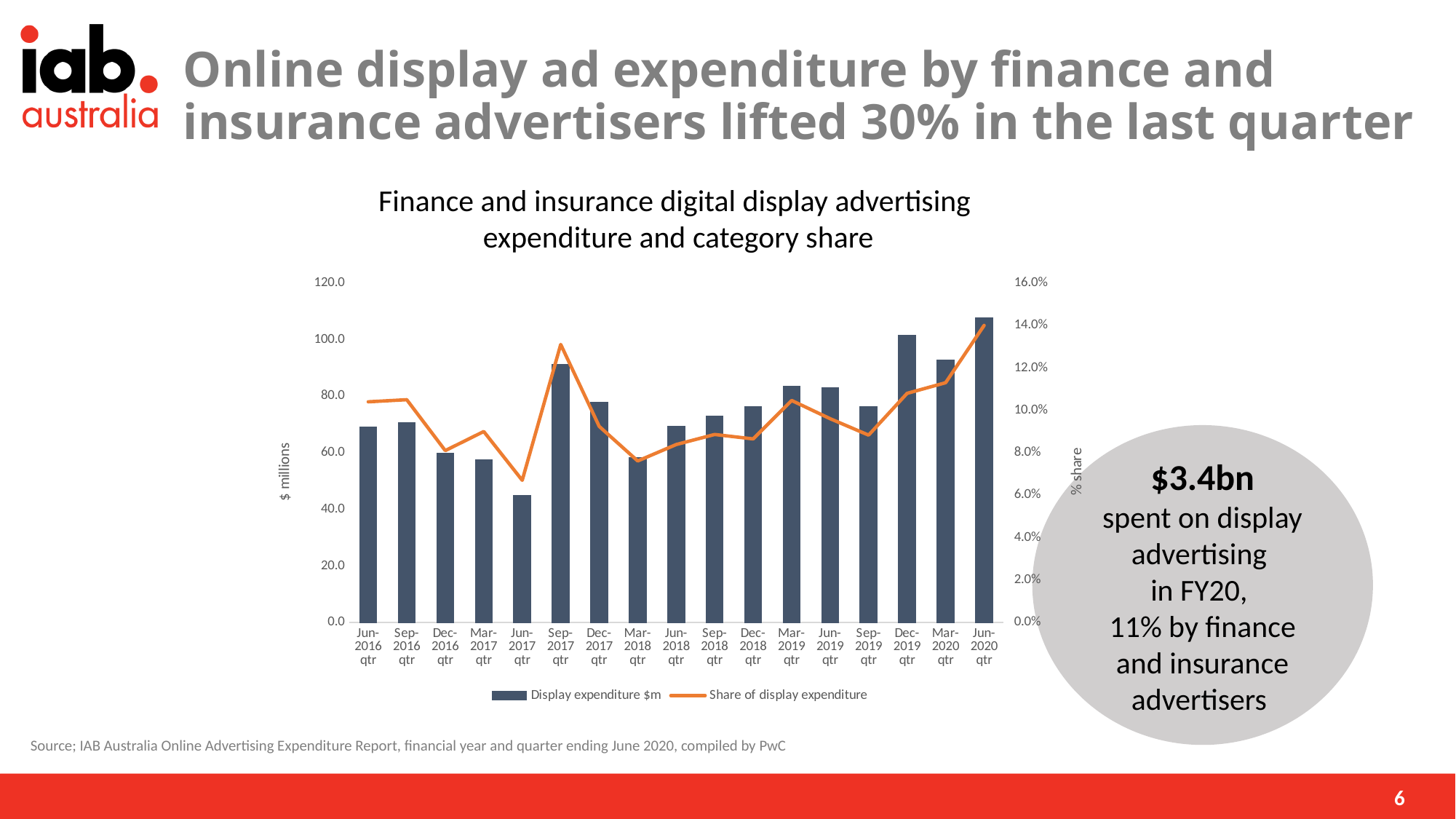
What kind of chart is used to show display expenditure in $m? Bar chart (with a line for share) How many quarters are shown on the x axis of the chart? 17 Which quarter has the lowest display expenditure bar? Jun-2017 qtr Is the display expenditure for the Jun-2020 qtr greater or less than 100.0 $ millions? greater What is the label of the left vertical axis of the chart? $ millions Is the share of display expenditure for the Jun-2017 qtr greater or less than 8.0%? less Which quarter has the highest display expenditure bar? Jun-2020 qtr Which quarter has the lowest share of display expenditure on the line? Jun-2017 qtr How many series does the chart legend list? 2 Which quarter has a higher display expenditure bar, Sep-2017 qtr or Dec-2017 qtr? Sep-2017 qtr Is the share of display expenditure for the Jun-2020 qtr greater or less than 12.0%? greater